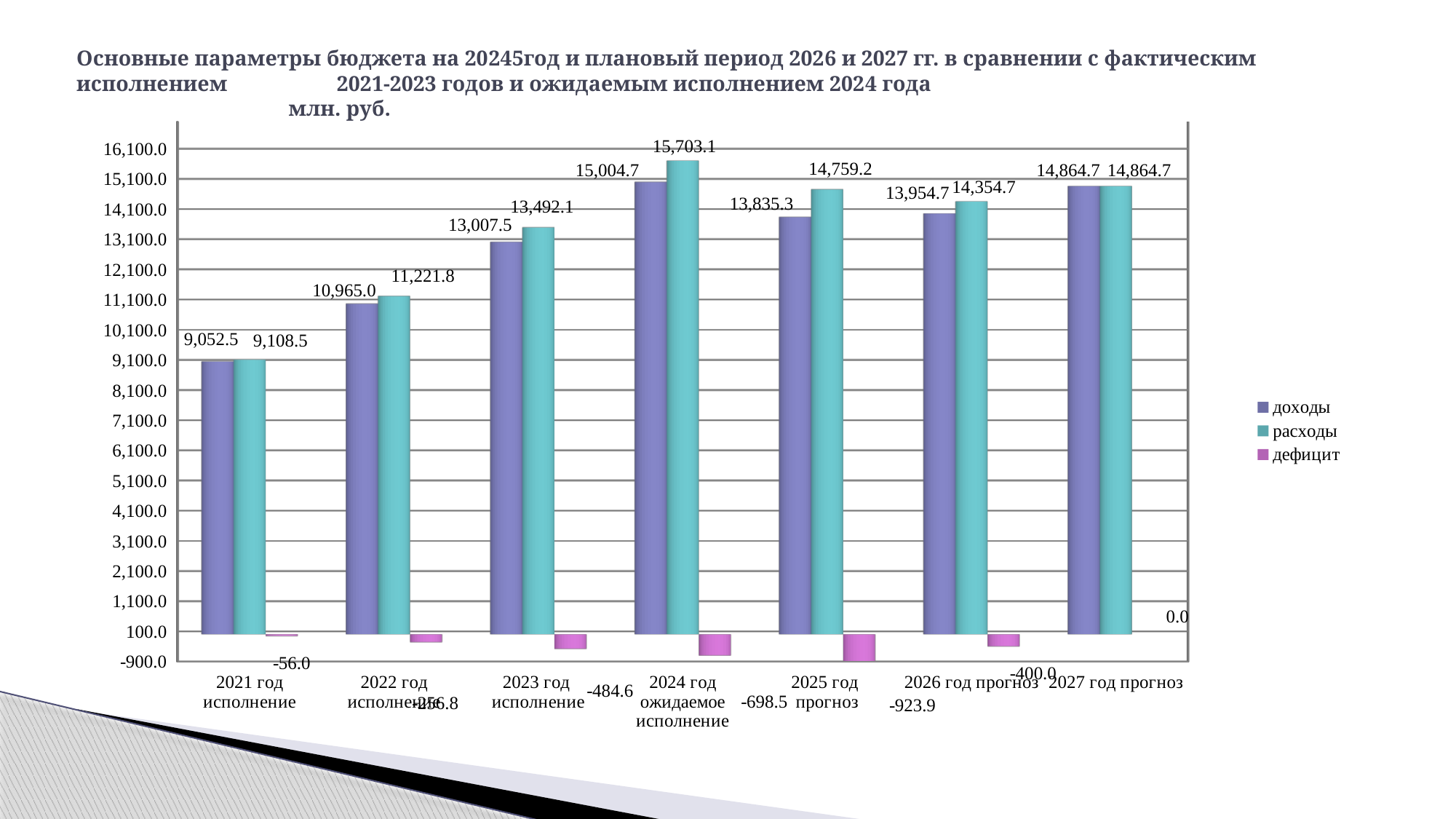
What is the difference between расходы and доходы for 2026 год прогноз? 400.0 How many series does the legend list? 3 Which series is shown in pink/magenta in the legend? дефицит What is the value of доходы for 2021 год исполнение? 9,052.5 What is the value of доходы for 2025 год прогноз? 13,835.3 What is the value of расходы for 2024 год ожидаемое исполнение? 15,703.1 What type of chart is shown on the slide? bar chart Which year has the highest value of расходы? 2024 год ожидаемое исполнение How many year categories are shown on the x axis? 7 What is the value of дефицит for 2027 год прогноз? 0.0 Which is larger for 2023 год исполнение, доходы or расходы? расходы Which year has the lowest value of доходы? 2021 год исполнение